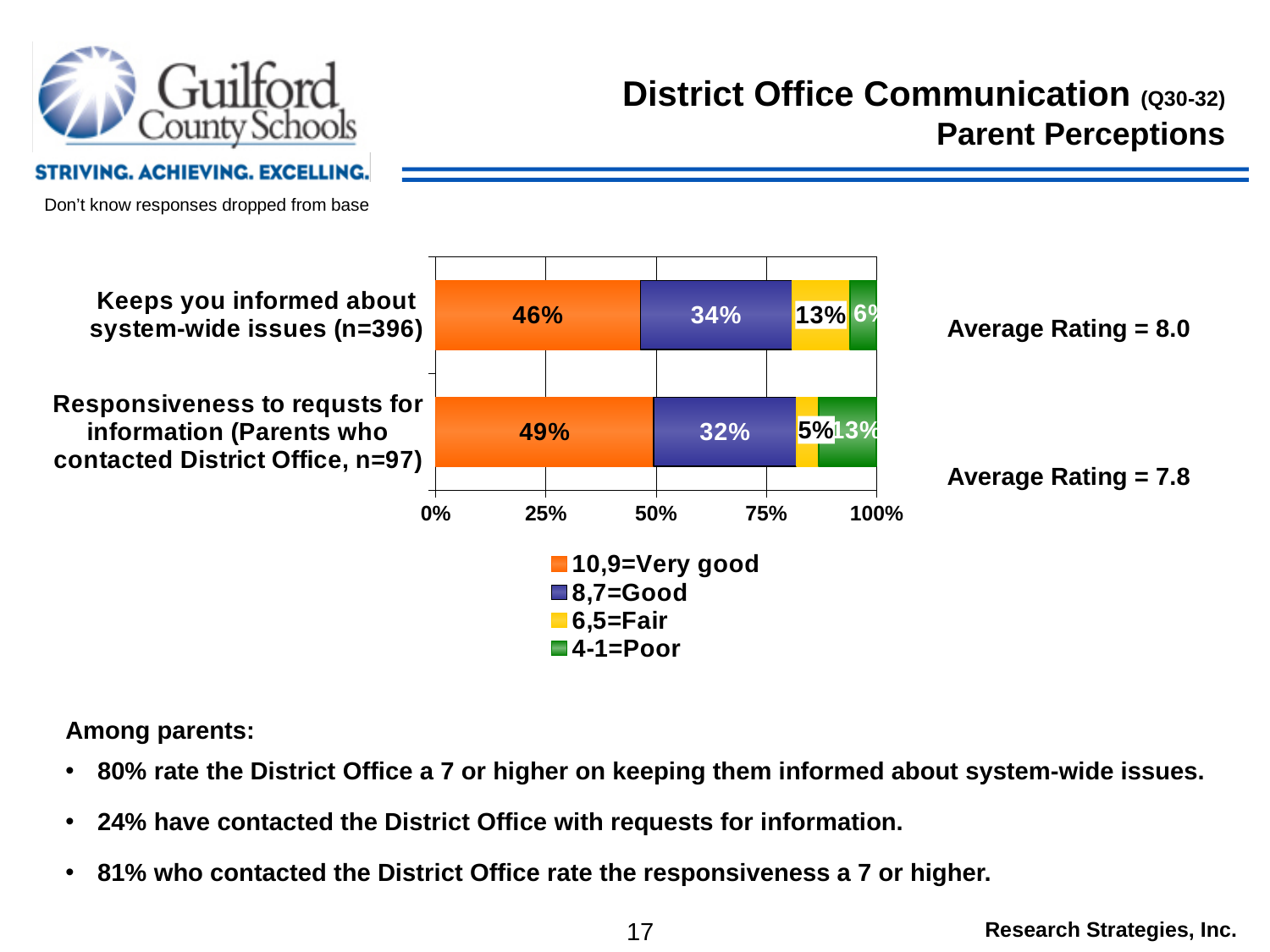
Which item has the larger Very good (10,9) share: "Keeps you informed about system-wide issues" or "Responsiveness to requests for information"? Responsiveness to requests for information What percentage of parents rated "Responsiveness to requests for information" as Very good (10,9)? 49% How many items (categories) are plotted in the chart? 2 What percentage of parents rated "Keeps you informed about system-wide issues" as Fair (6,5)? 13% What percentage of parents rated "Responsiveness to requests for information" as Fair (6,5)? 5% What percentage of parents rated "Keeps you informed about system-wide issues" as Very good (10,9)? 46% What is the difference in the Very good (10,9) share between "Responsiveness to requests for information" and "Keeps you informed about system-wide issues"? 3 percentage points What type of chart is shown on the slide? Stacked bar chart What is the difference in the Good (8,7) share between "Keeps you informed about system-wide issues" and "Responsiveness to requests for information"? 2 percentage points Which rating category does the orange segment represent in the chart legend? 10,9=Very good What percentage of parents rated "Responsiveness to requests for information" as Good (8,7)? 32% How many series does the chart legend list? 4